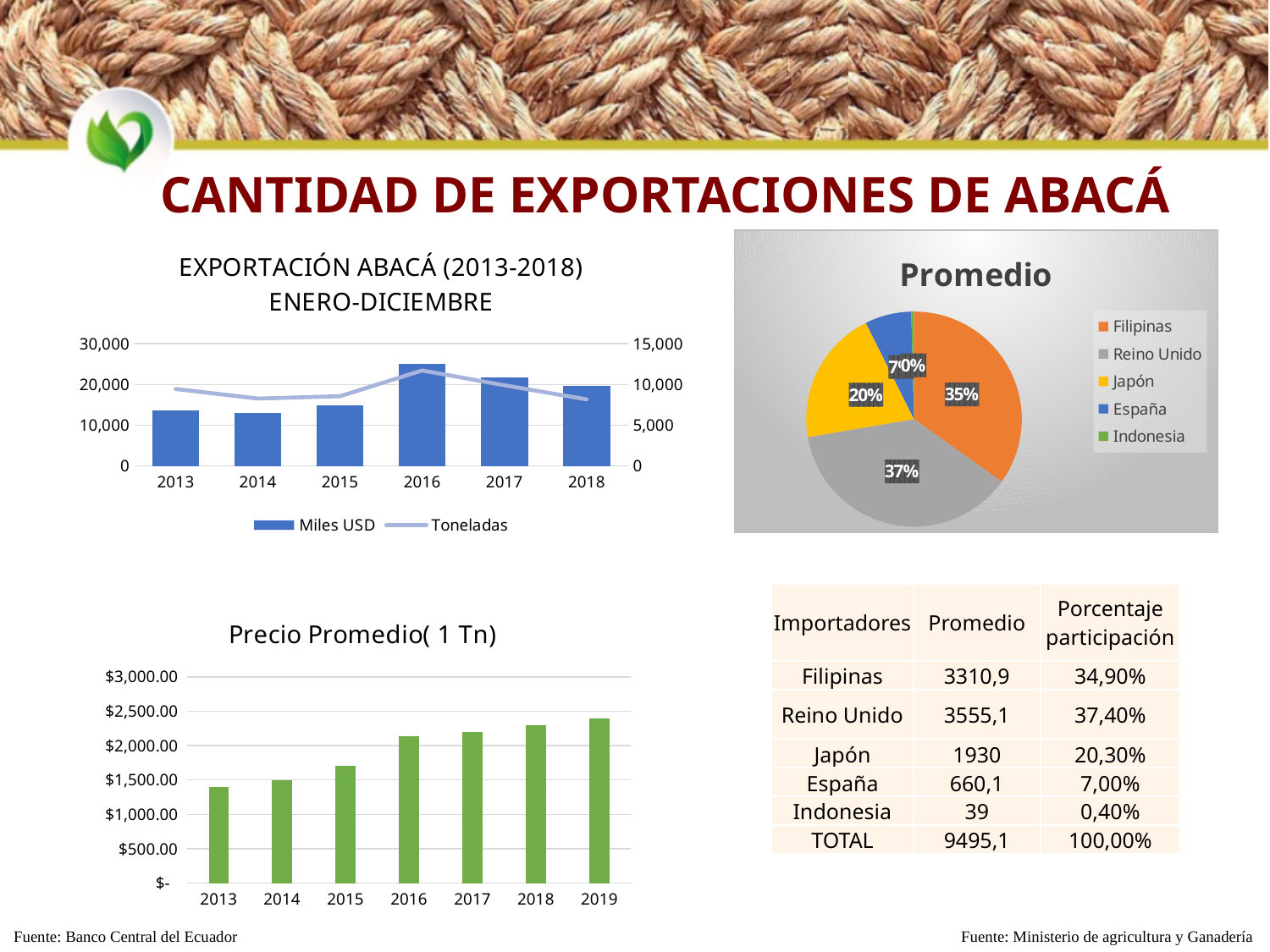
In the 'EXPORTACIÓN ABACÁ (2013-2018) ENERO-DICIEMBRE' chart, how many series does the legend list? 2 In the 'Precio Promedio( 1 Tn)' chart, which year has the highest value? 2019 In the 'EXPORTACIÓN ABACÁ (2013-2018) ENERO-DICIEMBRE' chart, is the Miles USD value for 2016 greater or less than 20,000? greater In the 'Promedio' pie chart, which importer has the smallest slice? Indonesia In the 'Precio Promedio( 1 Tn)' chart, what kind of chart is it? Bar chart In the 'EXPORTACIÓN ABACÁ (2013-2018) ENERO-DICIEMBRE' chart, is the Toneladas value for 2016 greater or less than 10,000? greater In the 'Promedio' pie chart, what share does Reino Unido have? 37% In the 'Promedio' pie chart, what share does Japón have? 20% In the 'Precio Promedio( 1 Tn)' chart, is the value for 2013 greater or less than $1,500.00? less In the 'EXPORTACIÓN ABACÁ (2013-2018) ENERO-DICIEMBRE' chart, which year has the highest Miles USD bar? 2016 In the 'Promedio' pie chart, how many slices are listed in the legend? 5 In the 'Precio Promedio( 1 Tn)' chart, do the values rise or fall from 2013 to 2019? rise